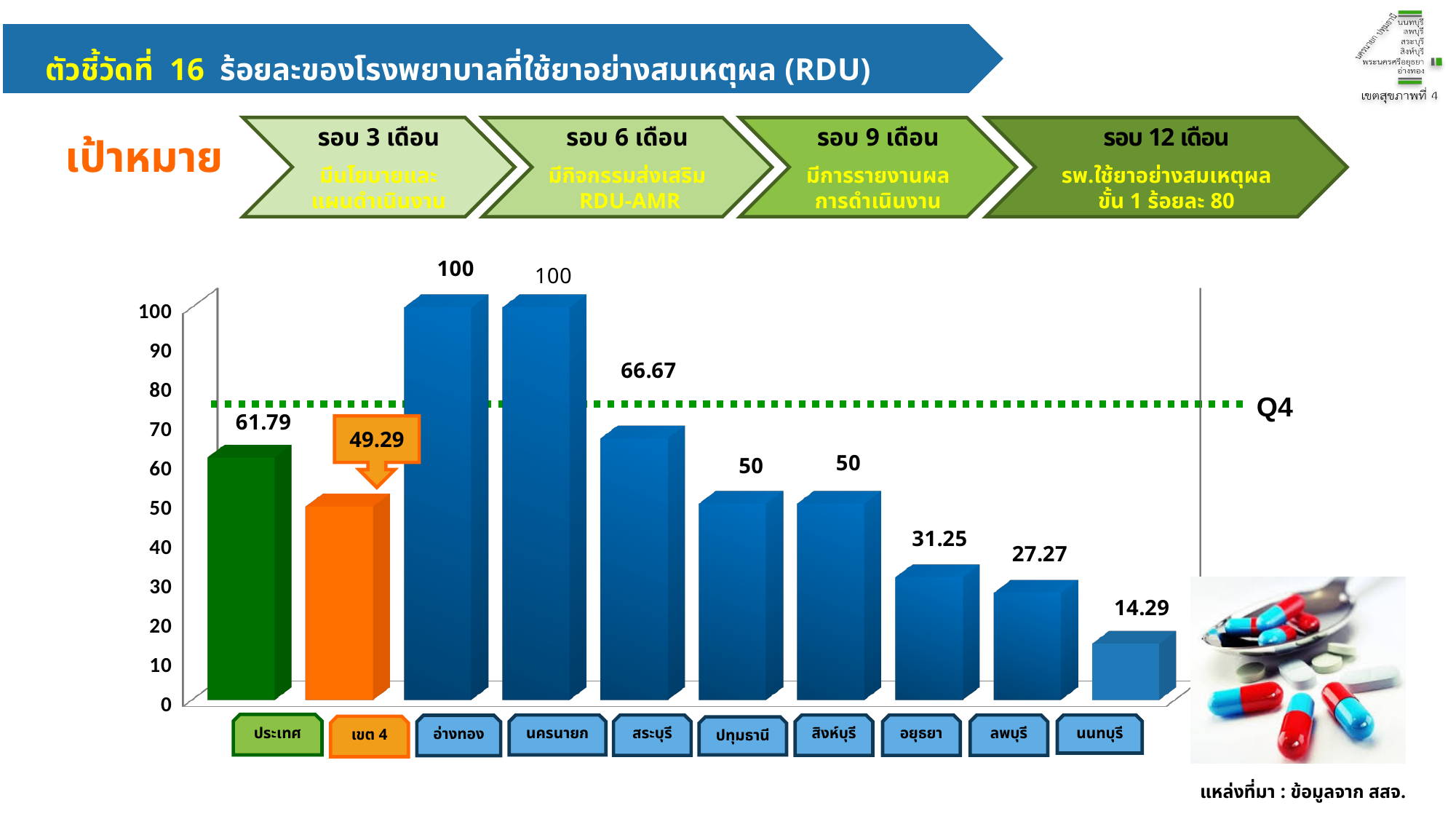
What is the value for อยุธยา? 31.25 Is the value for เขต 4 greater or less than 60? less Which category has the lowest value? นนทบุรี What is the value for นนทบุรี? 14.29 Which is larger, the value for ปทุมธานี or the value for อยุธยา? ปทุมธานี What is the value for เขต 4? 49.29 How many categories are shown on the x axis? 10 What kind of chart is shown on the slide? bar chart What is the difference between the values for สระบุรี and ลพบุรี? 39.40 What is the value for ประเทศ? 61.79 What is the difference between the values for ประเทศ and เขต 4? 12.50 What is the value for สระบุรี? 66.67